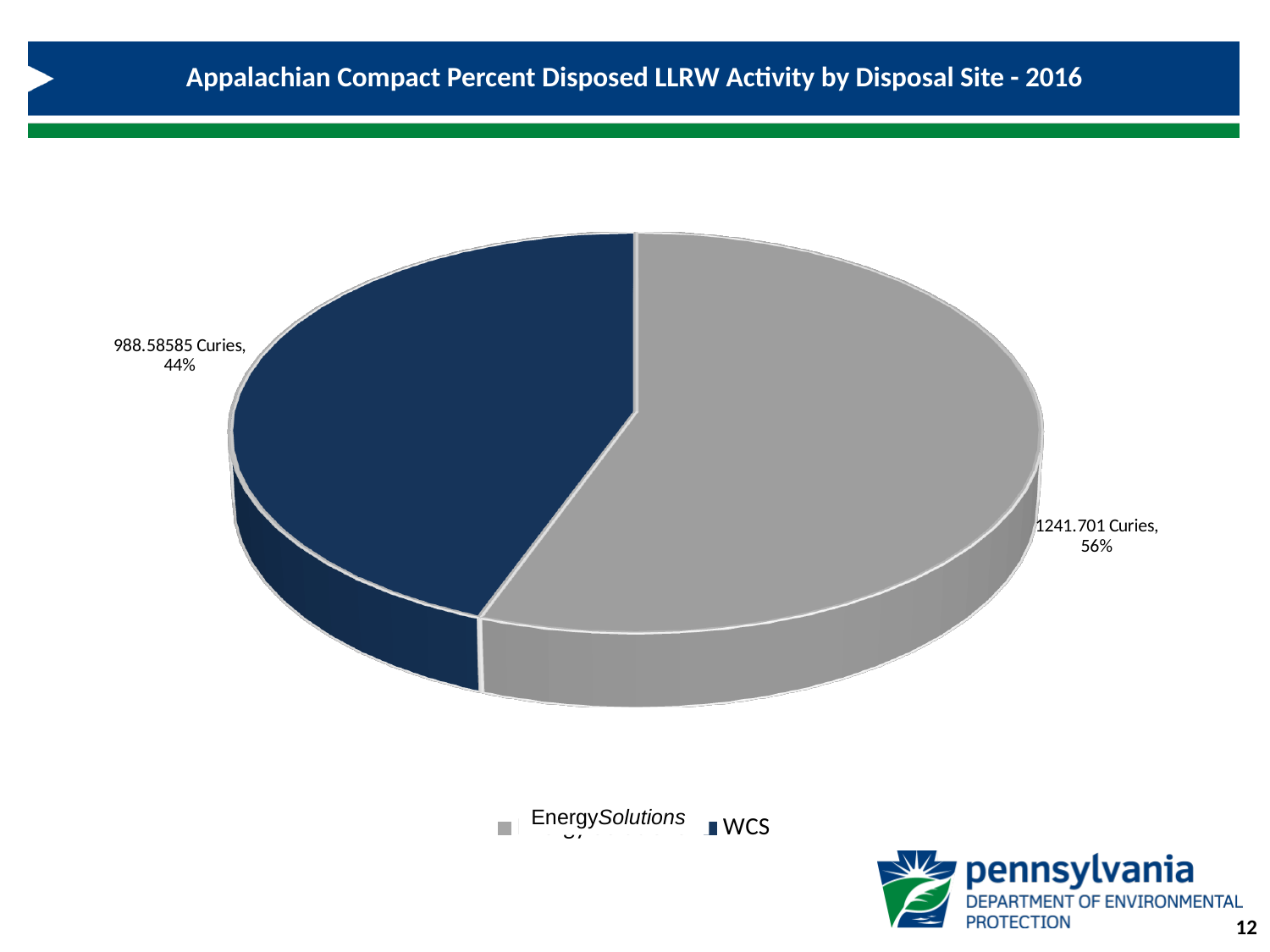
What percentage of the disposed LLRW activity went to WCS? 44% What is the disposed activity for WCS? 988.58585 Curies Which is larger, the activity disposed at EnergySolutions or at WCS? EnergySolutions How many slices does the pie chart have? 2 Which disposal site received the larger share of disposed activity? EnergySolutions How many entries does the legend list? 2 Which disposal site received the smaller share of disposed activity? WCS What kind of chart is shown on the slide? Pie chart Which colour represents WCS in the pie chart? Navy blue What is the difference in Curies between the EnergySolutions and WCS slices? 253.11515 Curies What percentage of the disposed LLRW activity went to EnergySolutions? 56% What is the disposed activity for EnergySolutions? 1241.701 Curies